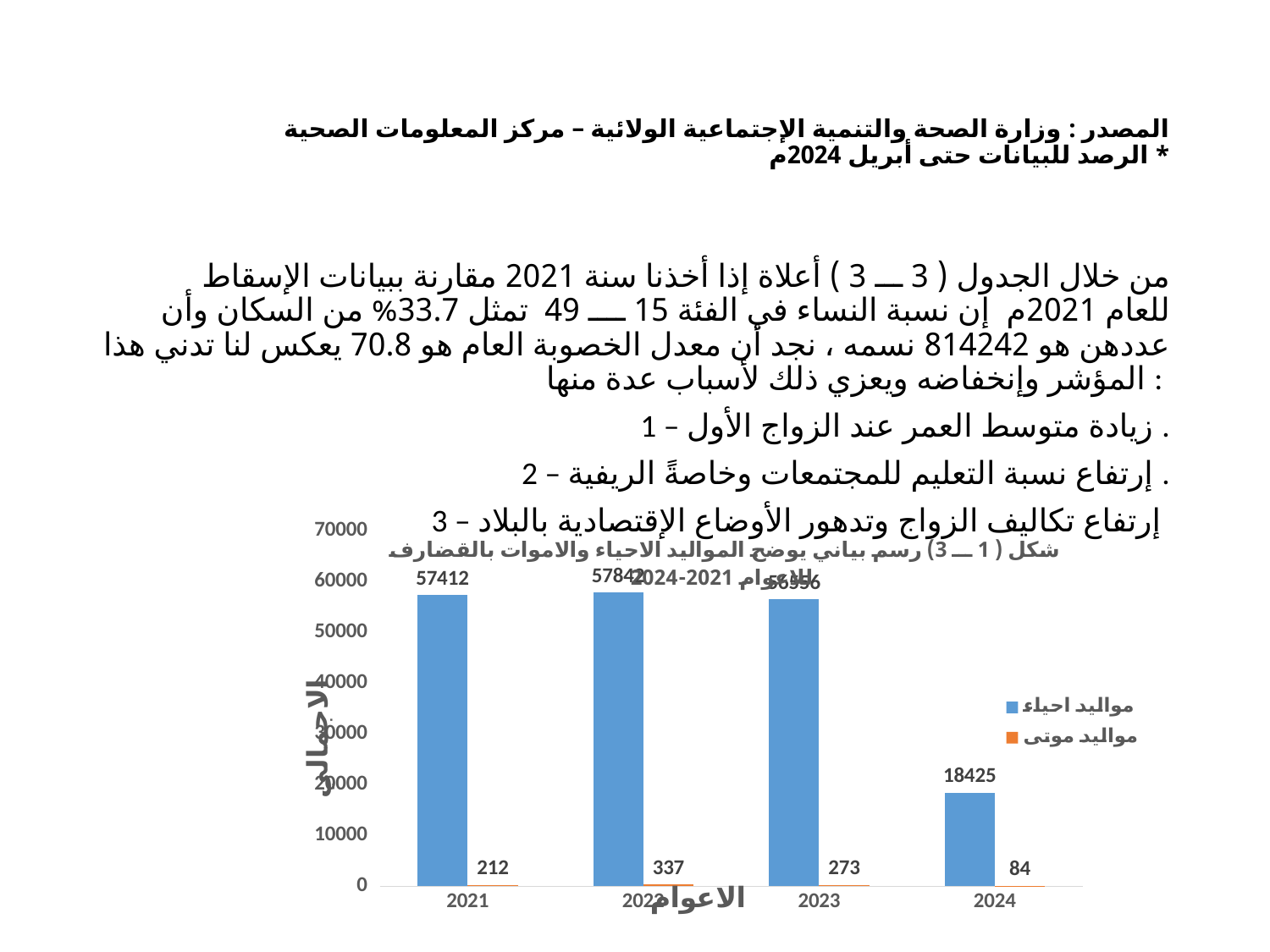
What kind of chart is shown on the slide? bar chart How many years are shown on the x axis? 4 What is the difference between مواليد موتى in 2022 and in 2021? 125 Is the value for مواليد احياء in 2022 greater or less than 50000? greater What is the value for مواليد موتى in 2024? 84 What is the value for مواليد احياء in 2021? 57412 What is the value for مواليد احياء in 2024? 18425 What is the value for مواليد موتى in 2022? 337 Which year has the lowest value for مواليد احياء? 2024 What is the difference between مواليد احياء in 2021 and in 2024? 38987 Which year has the highest value for مواليد موتى? 2022 How many series does the legend list? 2